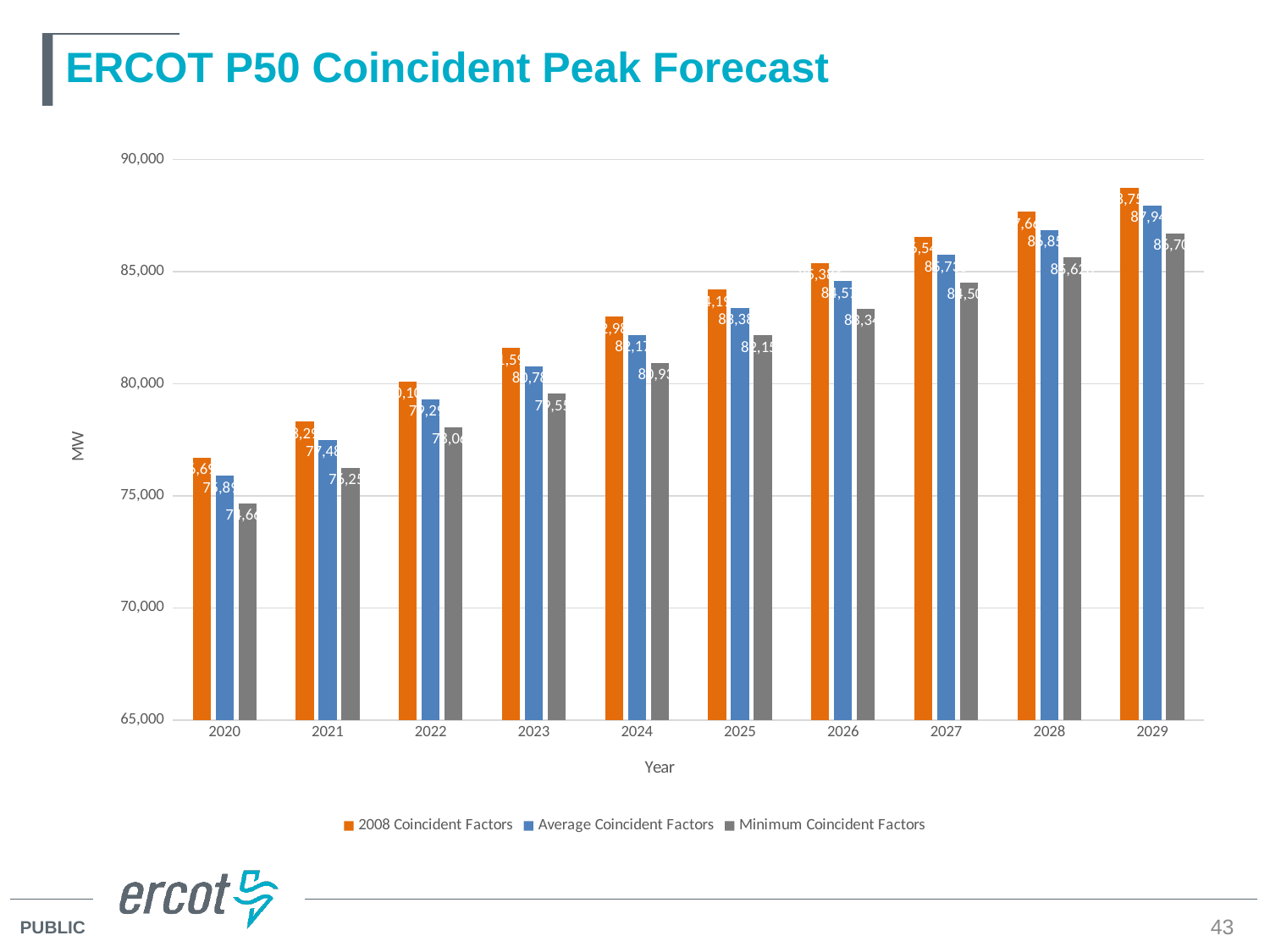
Is the value for 2008 Coincident Factors in 2029 greater or less than 85,000? greater What is the label on the y axis? MW What is the title of the chart? ERCOT P50 Coincident Peak Forecast What kind of chart is shown on the slide? bar chart How many series does the legend list? 3 Which year has the highest value for the 2008 Coincident Factors series? 2029 Which year has the lowest value for the Minimum Coincident Factors series? 2020 Is the value for Average Coincident Factors in 2024 greater or less than 80,000? greater Is the value for Minimum Coincident Factors in 2020 greater or less than 75,000? less Do the values for the 2008 Coincident Factors series rise or fall from 2020 to 2029? rise How many years are shown on the x axis? 10 In 2025, which is larger: the 2008 Coincident Factors value or the Minimum Coincident Factors value? 2008 Coincident Factors